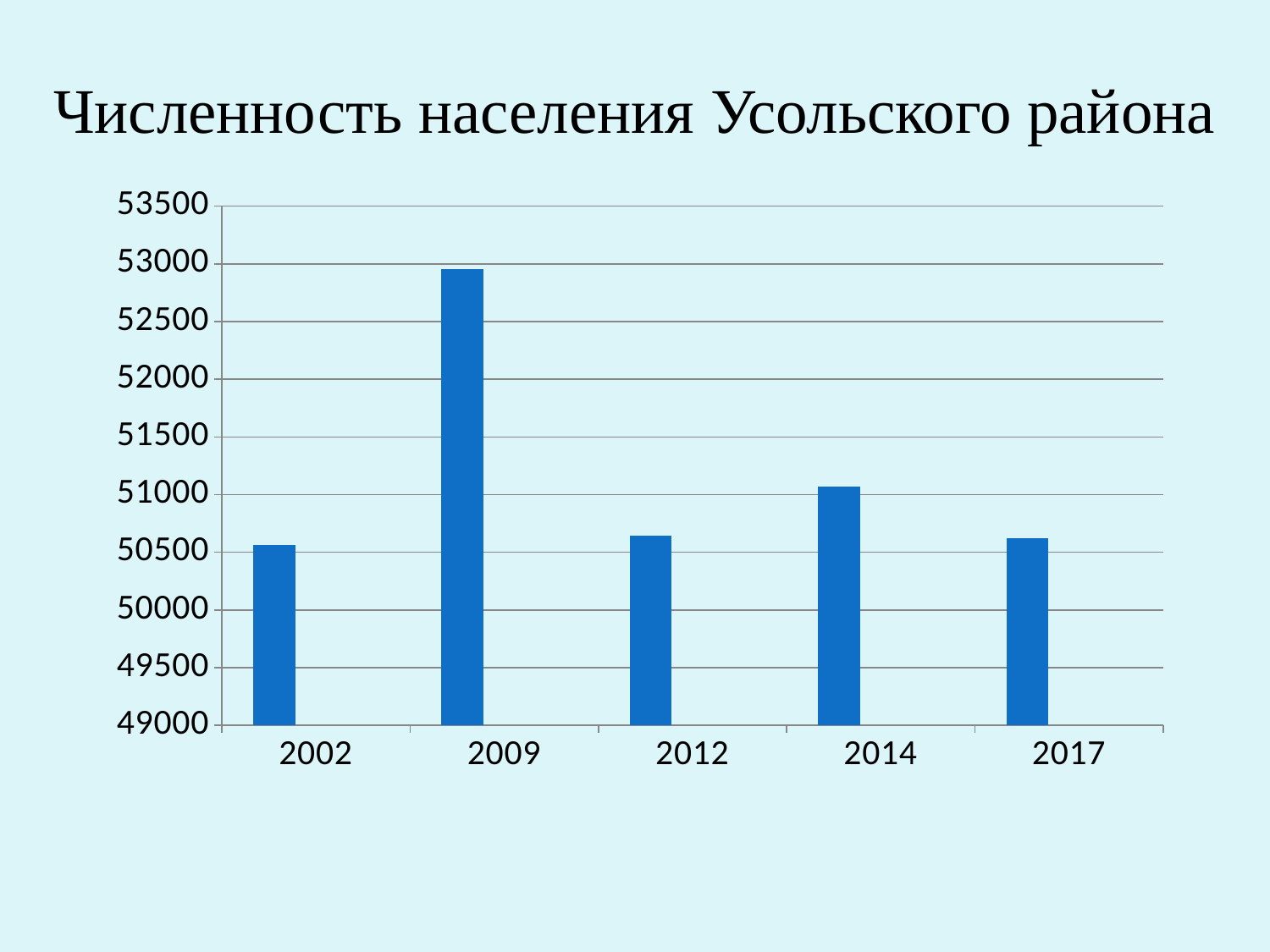
Does the value rise or fall from 2009 to 2012? fall Is the value for 2017 greater or less than 50000? greater What kind of chart is shown on the slide? bar chart What is the title of the chart? Численность населения Усольского района Is the value for 2012 greater or less than 50500? greater Is the value for 2014 greater or less than 51500? less Which is larger, the value for 2014 or the value for 2012? 2014 Which year has the highest population value in the chart? 2009 How many years are shown on the x axis of the chart? 5 Which is larger, the value for 2009 or the value for 2014? 2009